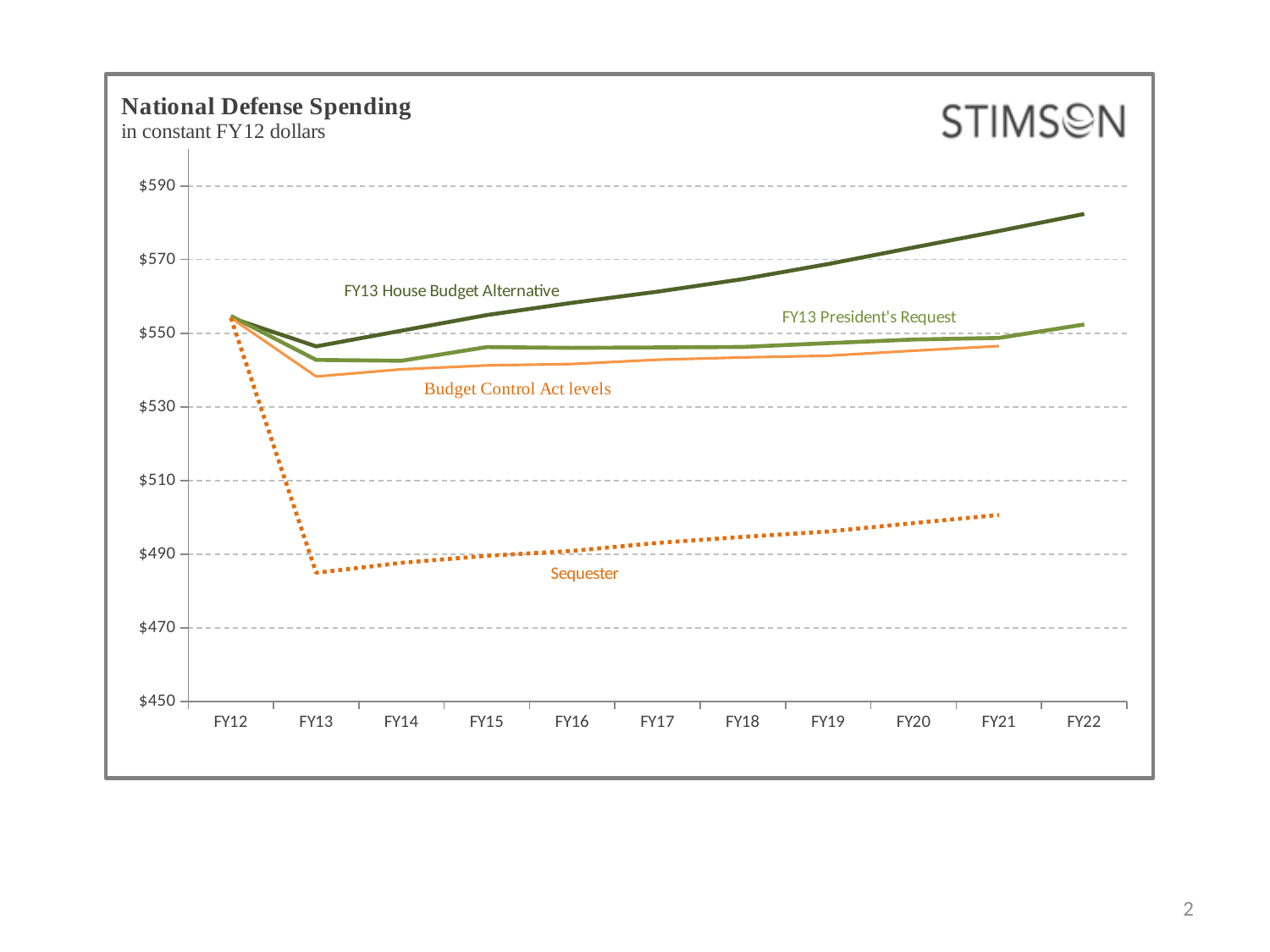
Is the FY13 House Budget Alternative value at FY22 greater or less than $570? greater What is the title of the chart? National Defense Spending Is the Sequester value at FY21 greater or less than $490? greater How many fiscal years are shown on the x axis? 11 What kind of chart is shown on the slide? line chart How many series are plotted on the chart? 4 Does the FY13 House Budget Alternative line rise or fall from FY13 to FY22? rise Which series has the lowest values across the chart? Sequester Is the Budget Control Act levels value at FY13 greater or less than $530? greater At FY22, which is larger: FY13 House Budget Alternative or FY13 President's Request? FY13 House Budget Alternative Which series has the highest value at FY22? FY13 House Budget Alternative